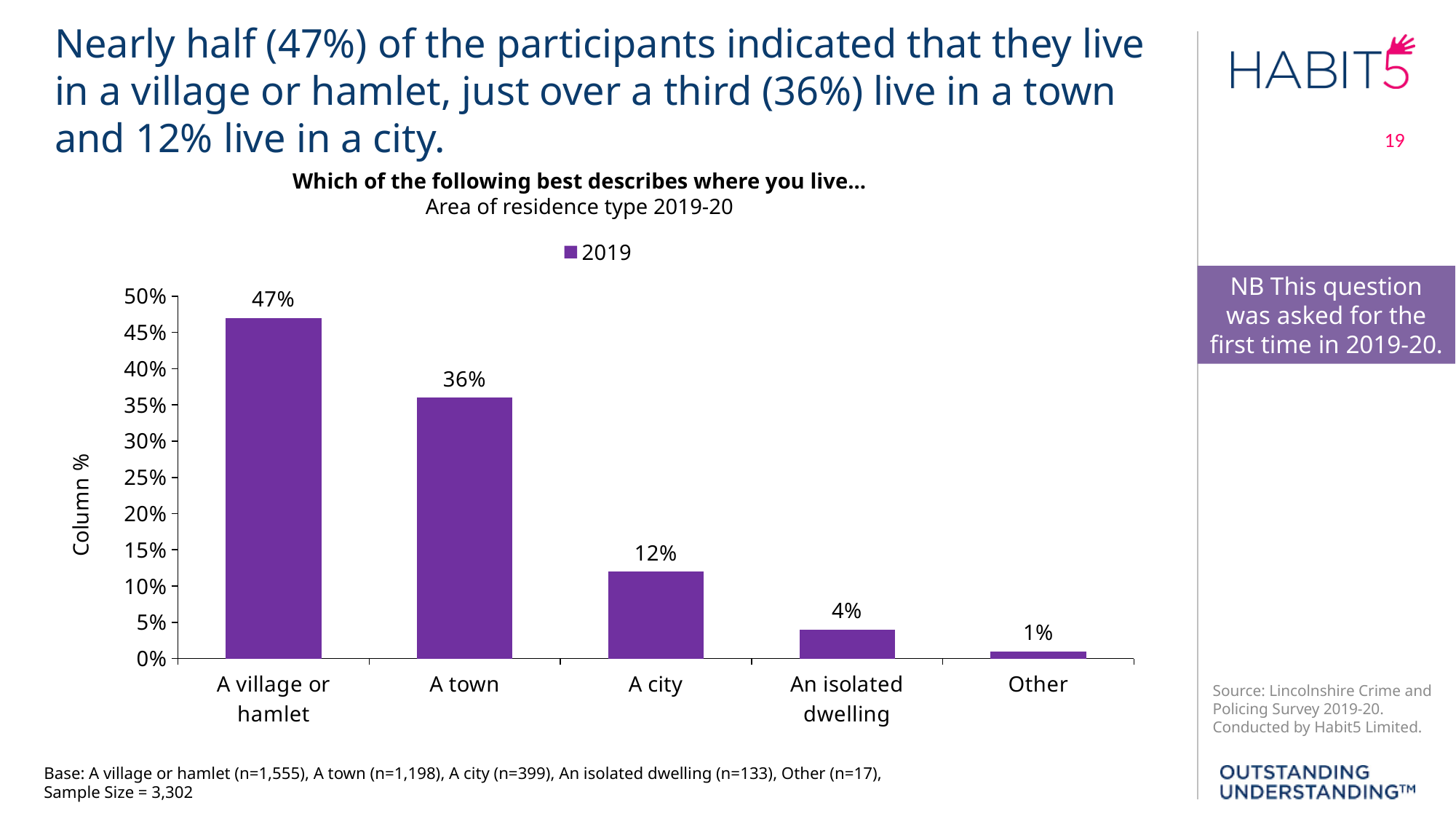
What percentage of participants live in an isolated dwelling? 4% What is the value shown for 'A town'? 36% Which category has the lowest value on the chart? Other How many series does the legend list? 1 Which area of residence type has the highest percentage? A village or hamlet What percentage of participants said they live in a village or hamlet? 47% What type of chart is shown on the slide? Bar chart How many categories are shown on the x axis of the chart? 5 Which is larger, the value for 'A city' or the value for 'An isolated dwelling'? A city Is the value for 'A town' greater or less than 40%? less What is the label on the y axis of the chart? Column % What is the difference in percentage points between 'A village or hamlet' and 'A town'? 11 percentage points